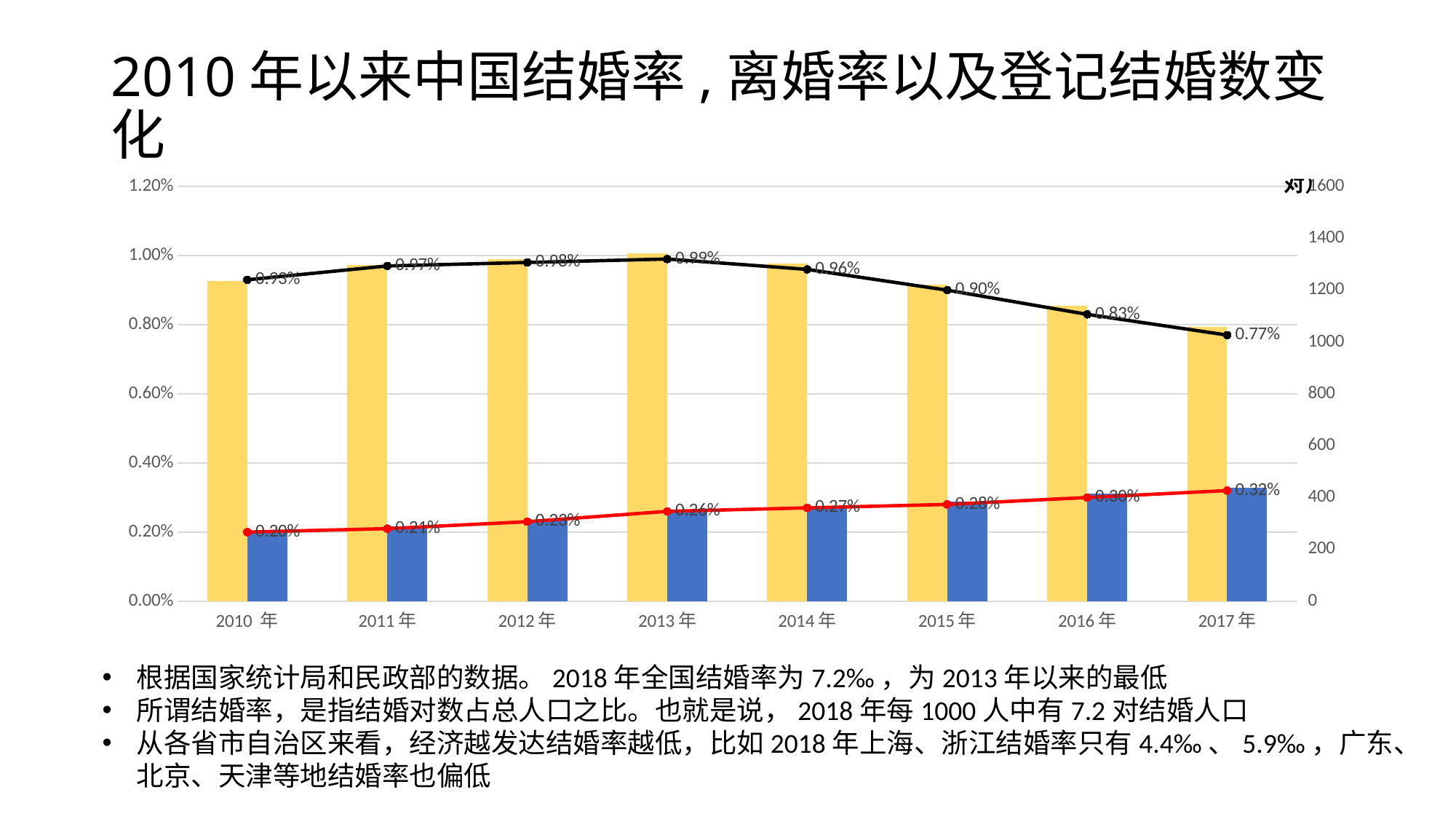
In which year does the red line have its lowest value? 2010 年 What value does the red line show for 2017 年? 0.32% What is the difference between the black line's value in 2013 年 and its value in 2017 年? 0.22% Does the red line rise or fall from 2010 年 to 2017 年? rise What value does the black line show for 2013 年? 0.99% What value does the red line show for 2012 年? 0.23% What value does the black line show for 2010 年? 0.93% In which year does the black line reach its lowest value? 2017 年 Is the yellow bar for 2017 年 greater or less than 1200 on the right-hand axis? less Which is larger: the red line's value in 2016 年 or its value in 2014 年? 2016 年 In which year does the black line reach its highest value? 2013 年 How many years are shown on the x axis? 8